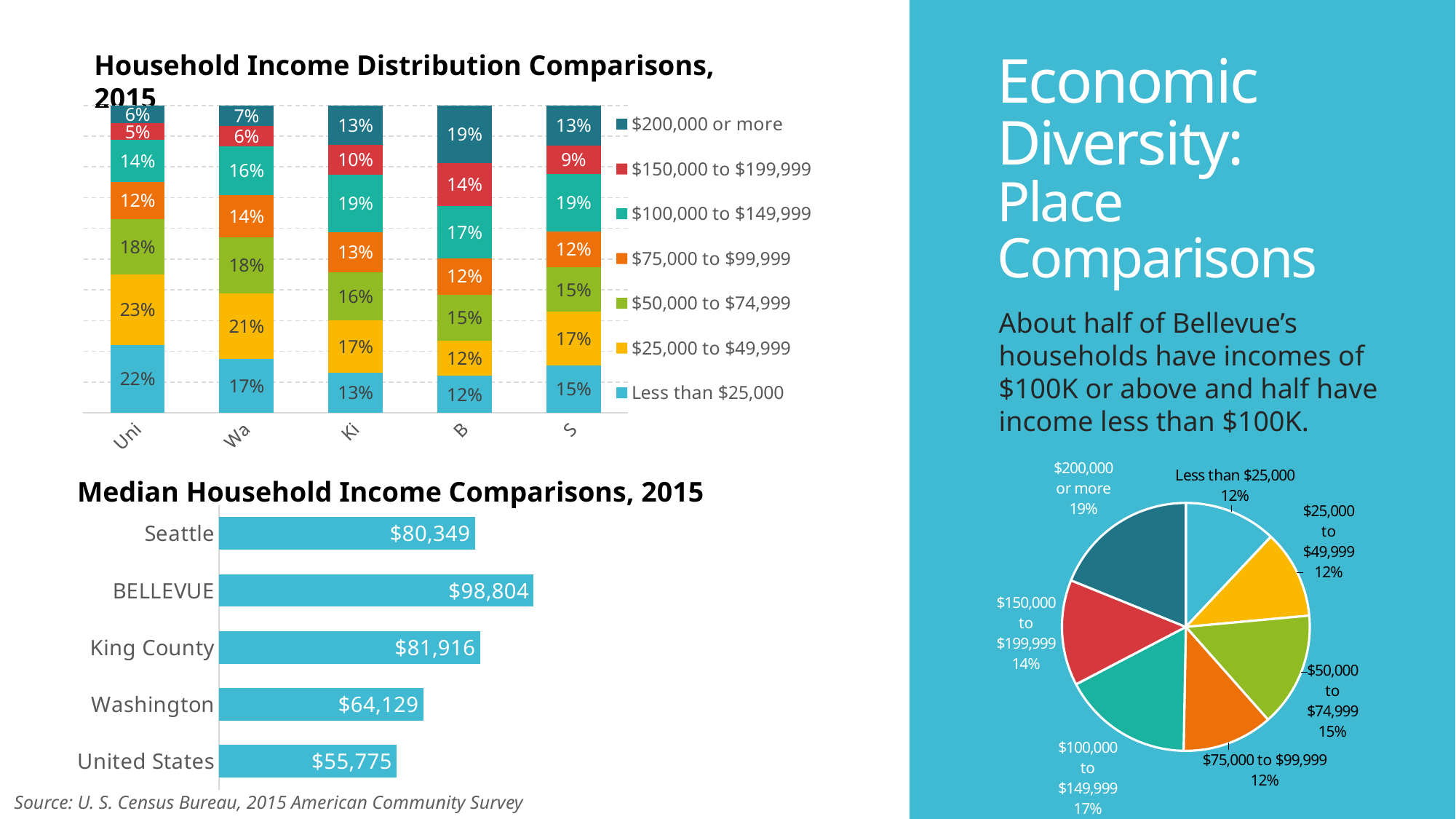
In the Median Household Income Comparisons, 2015 chart, how much higher is BELLEVUE's median household income than Seattle's? $18,455 In the Household Income Distribution Comparisons, 2015 chart, what percentage of the first bar (labelled 'Uni') is in the 'Less than $25,000' category? 22% In the Median Household Income Comparisons, 2015 chart, which has the larger median household income, King County or Seattle? King County In the Median Household Income Comparisons, 2015 chart, which place has the highest median household income? BELLEVUE How many series does the legend of the Household Income Distribution Comparisons, 2015 chart list? 7 How many slices does the pie chart on the right side of the slide have? 7 What kind of chart is the Median Household Income Comparisons, 2015 chart? Bar chart In the pie chart on the right side of the slide, which income bracket has the largest slice? $200,000 or more How many places are shown in the Median Household Income Comparisons, 2015 chart? 5 In the Median Household Income Comparisons, 2015 chart, which place has the lowest median household income? United States In the Median Household Income Comparisons, 2015 chart, what is the median household income for BELLEVUE? $98,804 In the pie chart on the right side of the slide, what share of households have incomes of $200,000 or more? 19%